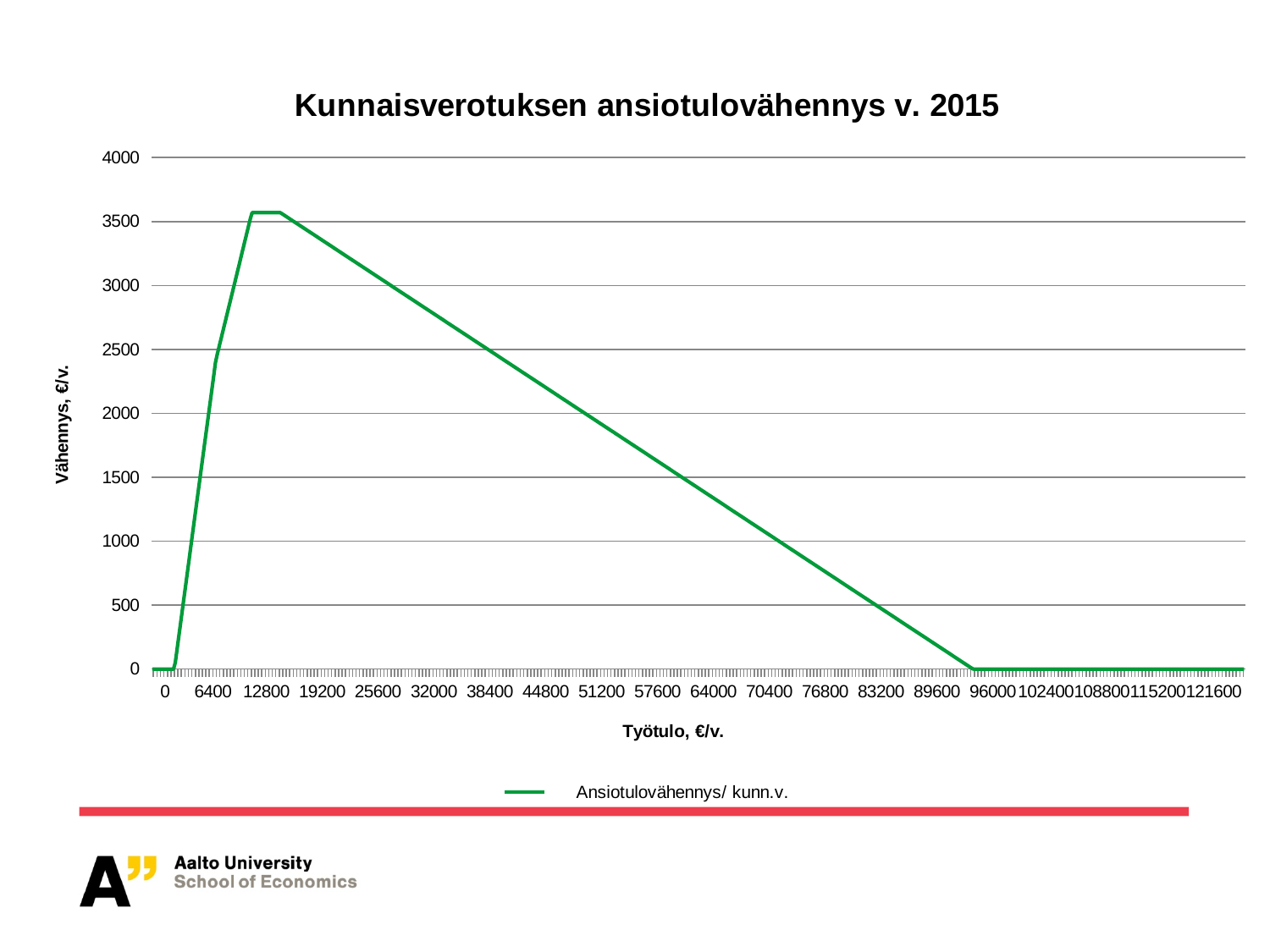
Between a Työtulo of 19200 and 89600, does the line rise or fall? fall Is the value at a Työtulo of 89600 greater or less than 500? less Is the value at a Työtulo of 32000 greater or less than 2500? greater Which is larger: the value at a Työtulo of 25600 or at 70400? 25600 What is the title of the chart? Kunnaisverotuksen ansiotulovähennys v. 2015 What kind of chart is shown on the slide? line chart Is the peak value of the line greater or less than 3500? greater What is the value of the line at a Työtulo of 121600? 0 How many series does the legend list? 1 What is the legend entry for the plotted line? Ansiotulovähennys/ kunn.v. What is the value of the line at a Työtulo of 0? 0